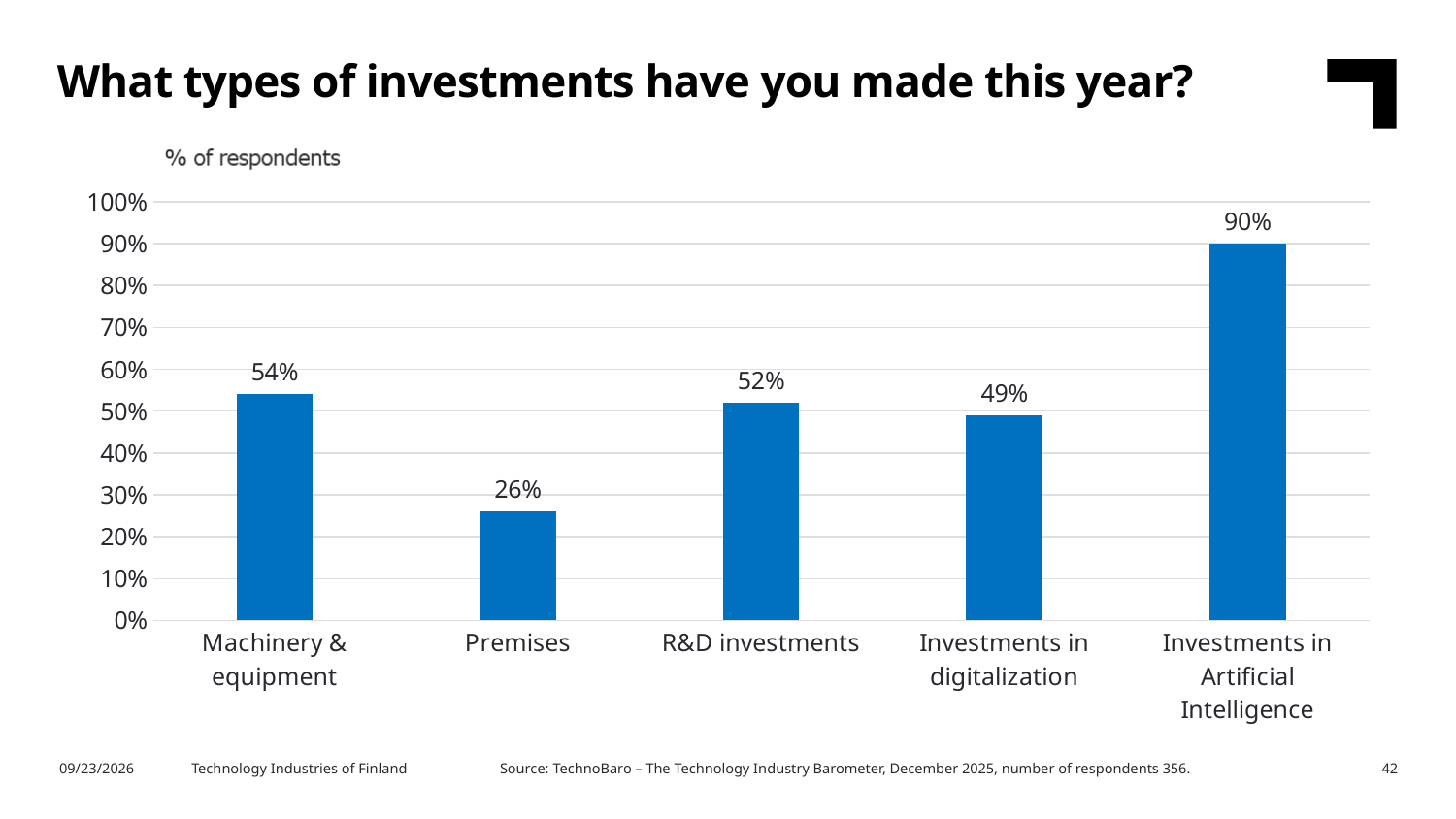
How many investment categories are shown in the chart? 5 What kind of chart is shown on the slide? Bar chart What is the difference between the values for Investments in Artificial Intelligence and Machinery & equipment? 36% What percentage of respondents made R&D investments? 52% What is the value for Investments in digitalization? 49% What is the label shown above the chart describing the y-axis values? % of respondents What percentage of respondents made investments in Artificial Intelligence? 90% Which is larger, the value for Machinery & equipment or the value for R&D investments? Machinery & equipment Which investment type has the highest share of respondents? Investments in Artificial Intelligence What is the value for Premises? 26% Is the value for Investments in digitalization greater or less than 50%? less Which investment type has the lowest share of respondents? Premises